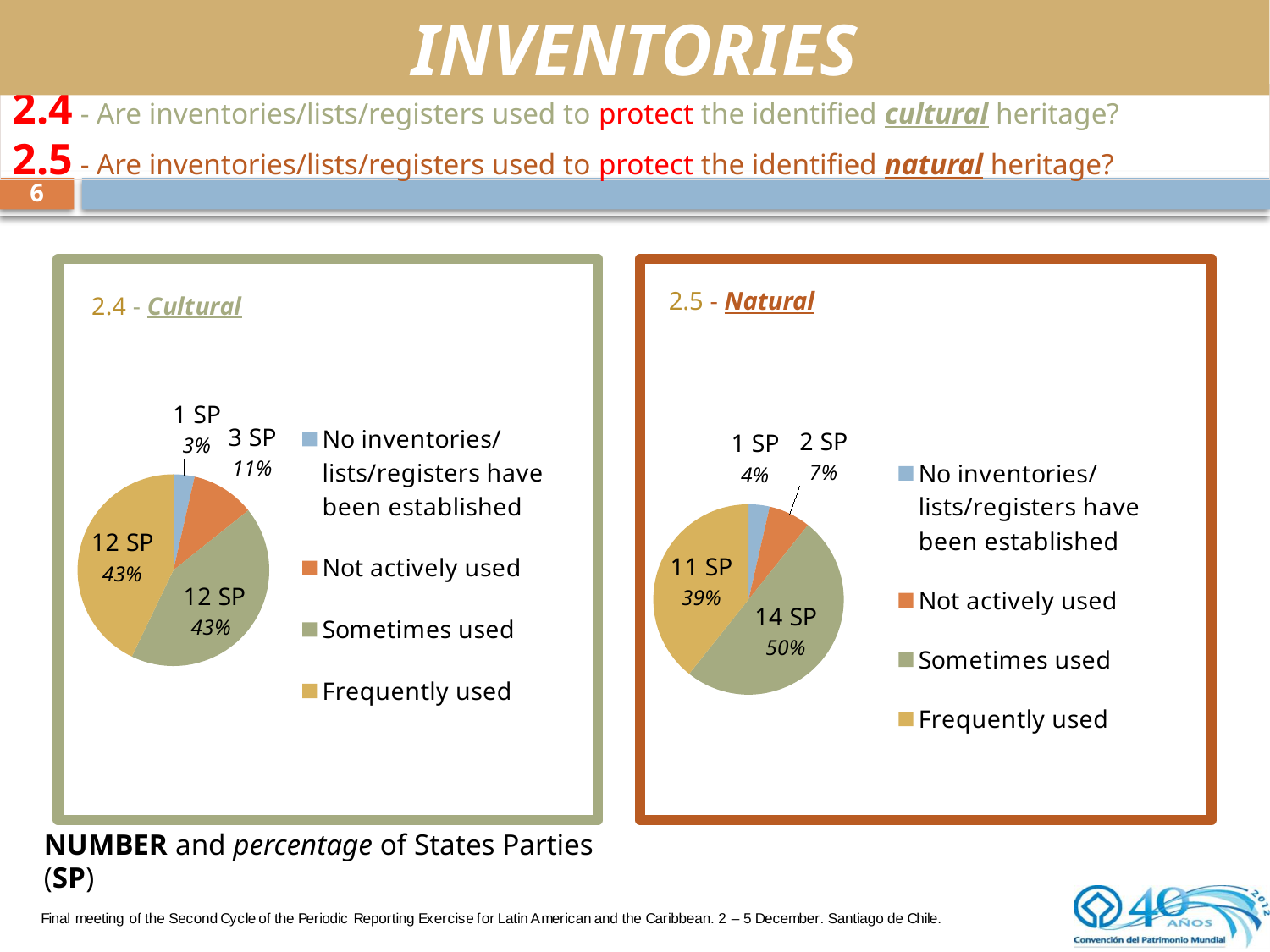
In the "2.4 - Cultural" chart, what is the difference in number of States Parties between "Sometimes used" and "Not actively used"? 9 SP In the "2.4 - Cultural" chart, what percentage of States Parties reported "Not actively used"? 11% In the "2.5 - Natural" chart, which category has the largest share? Sometimes used In the "2.5 - Natural" chart, what percentage of States Parties reported "Frequently used"? 39% In the "2.5 - Natural" chart, what share of the pie does "Sometimes used" represent? 50% In the "2.5 - Natural" chart, which is larger: "Not actively used" or "No inventories/lists/registers have been established"? Not actively used In the "2.4 - Cultural" chart, how many States Parties reported that no inventories/lists/registers have been established? 1 SP What type of chart is used in the "2.4 - Cultural" panel? pie chart In the "2.5 - Natural" chart, how many States Parties reported "Sometimes used"? 14 SP In the "2.4 - Cultural" chart, what colour represents "Frequently used"? yellow/gold In the "2.4 - Cultural" chart, which category has the smallest share? No inventories/lists/registers have been established How many categories does the legend of the "2.5 - Natural" chart list? 4